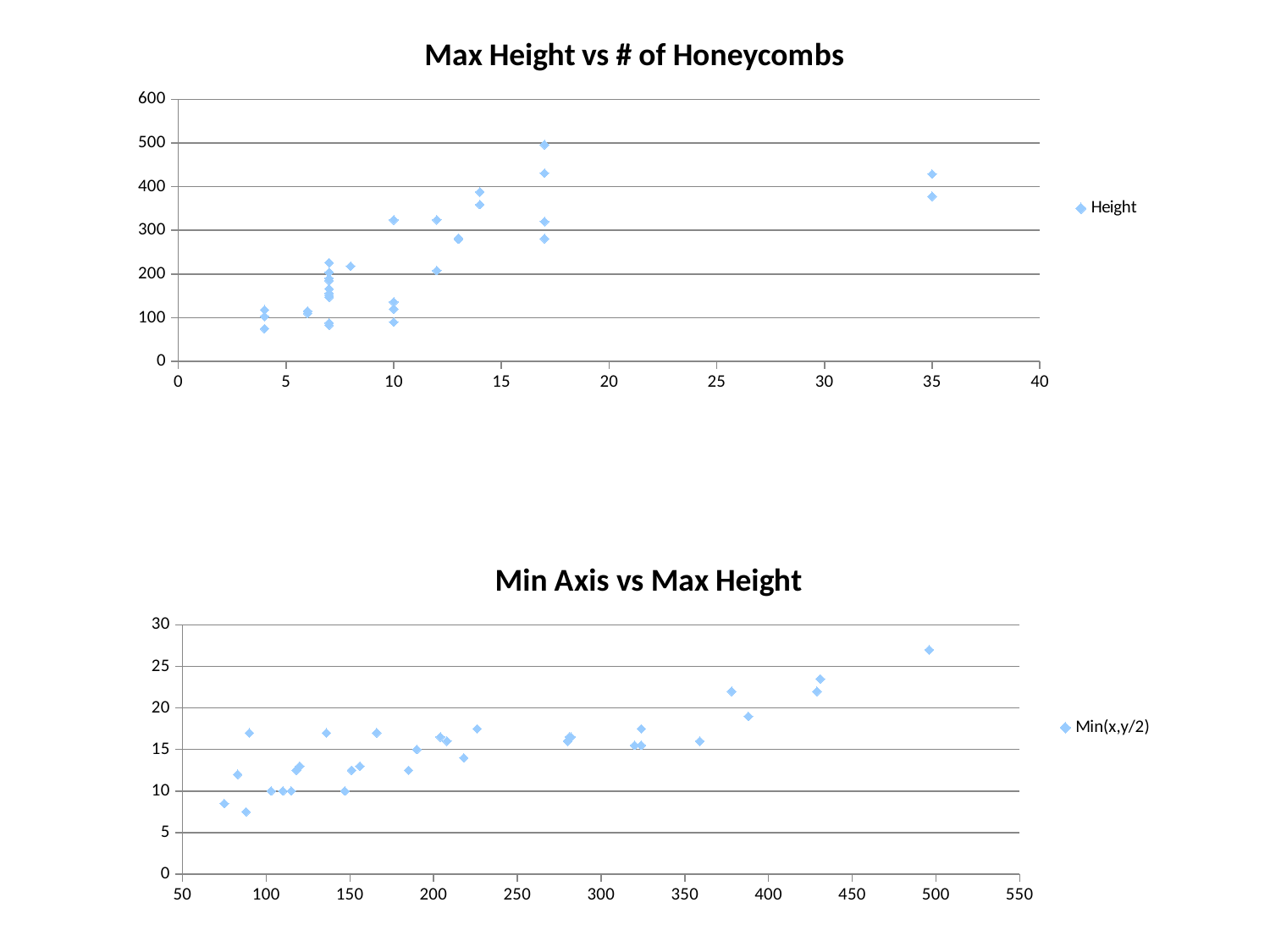
In the top chart "Max Height vs # of Honeycombs", how many series does the legend list? 1 In the bottom chart "Min Axis vs Max Height", do the plotted values generally rise or fall as the x value increases? rise What kind of chart is the top chart titled "Max Height vs # of Honeycombs"? scatter chart In the top chart "Max Height vs # of Honeycombs", is the lowest point plotted at x = 4 greater or less than 100? less In the top chart "Max Height vs # of Honeycombs", is the highest point plotted at x = 17 greater or less than 400? greater In the bottom chart "Min Axis vs Max Height", is the lowest point plotted near x = 90 greater or less than 10? less In the top chart "Max Height vs # of Honeycombs", do the plotted values generally rise or fall as the x value increases? rise In the bottom chart "Min Axis vs Max Height", what is the name of the series shown in the legend? Min(x,y/2) What kind of chart is the bottom chart titled "Min Axis vs Max Height"? scatter chart In the top chart "Max Height vs # of Honeycombs", what is the name of the series shown in the legend? Height